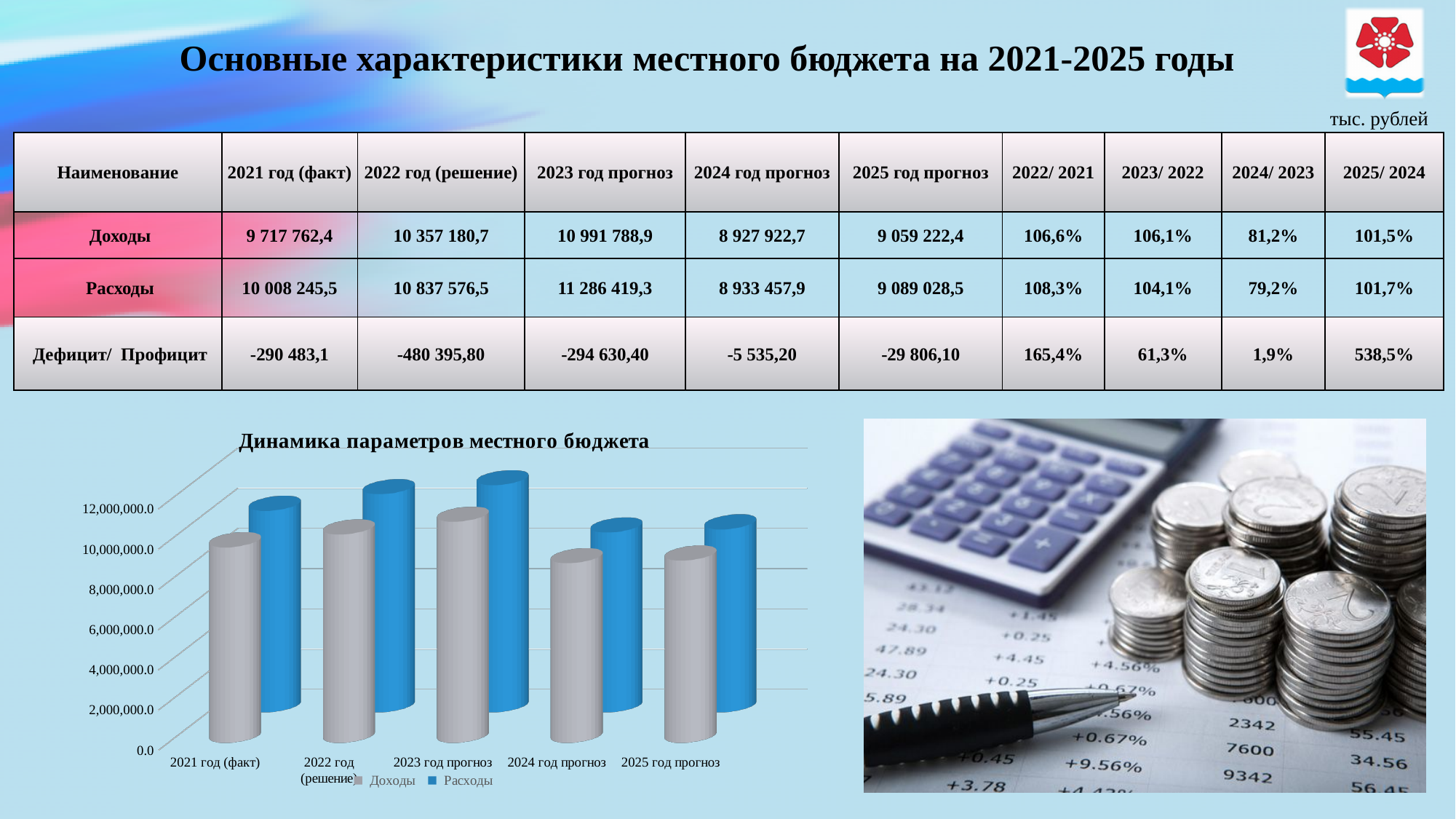
What kind of chart is "Динамика параметров местного бюджета"? bar chart How many series does the legend of the chart "Динамика параметров местного бюджета" list? 2 In the chart "Динамика параметров местного бюджета", which is larger for 2023 год прогноз: Доходы or Расходы? Расходы In the chart "Динамика параметров местного бюджета", is the Расходы value for 2023 год прогноз greater or less than 10,000,000.0? greater In the chart "Динамика параметров местного бюджета", do the Расходы bars rise or fall from 2021 год (факт) to 2023 год прогноз? rise In the chart "Динамика параметров местного бюджета", which series is shown in blue? Расходы In the chart "Динамика параметров местного бюджета", in which year is the Расходы bar the highest? 2023 год прогноз In the chart "Динамика параметров местного бюджета", in which year is the Доходы bar the highest? 2023 год прогноз In the chart "Динамика параметров местного бюджета", do the Доходы bars rise or fall from 2023 год прогноз to 2024 год прогноз? fall According to the table, what is the Доходы value for 2021 год (факт)? 9 717 762,4 In the chart "Динамика параметров местного бюджета", is the Доходы value for 2024 год прогноз greater or less than 8,000,000.0? greater How many year categories are shown on the x axis of the chart "Динамика параметров местного бюджета"? 5